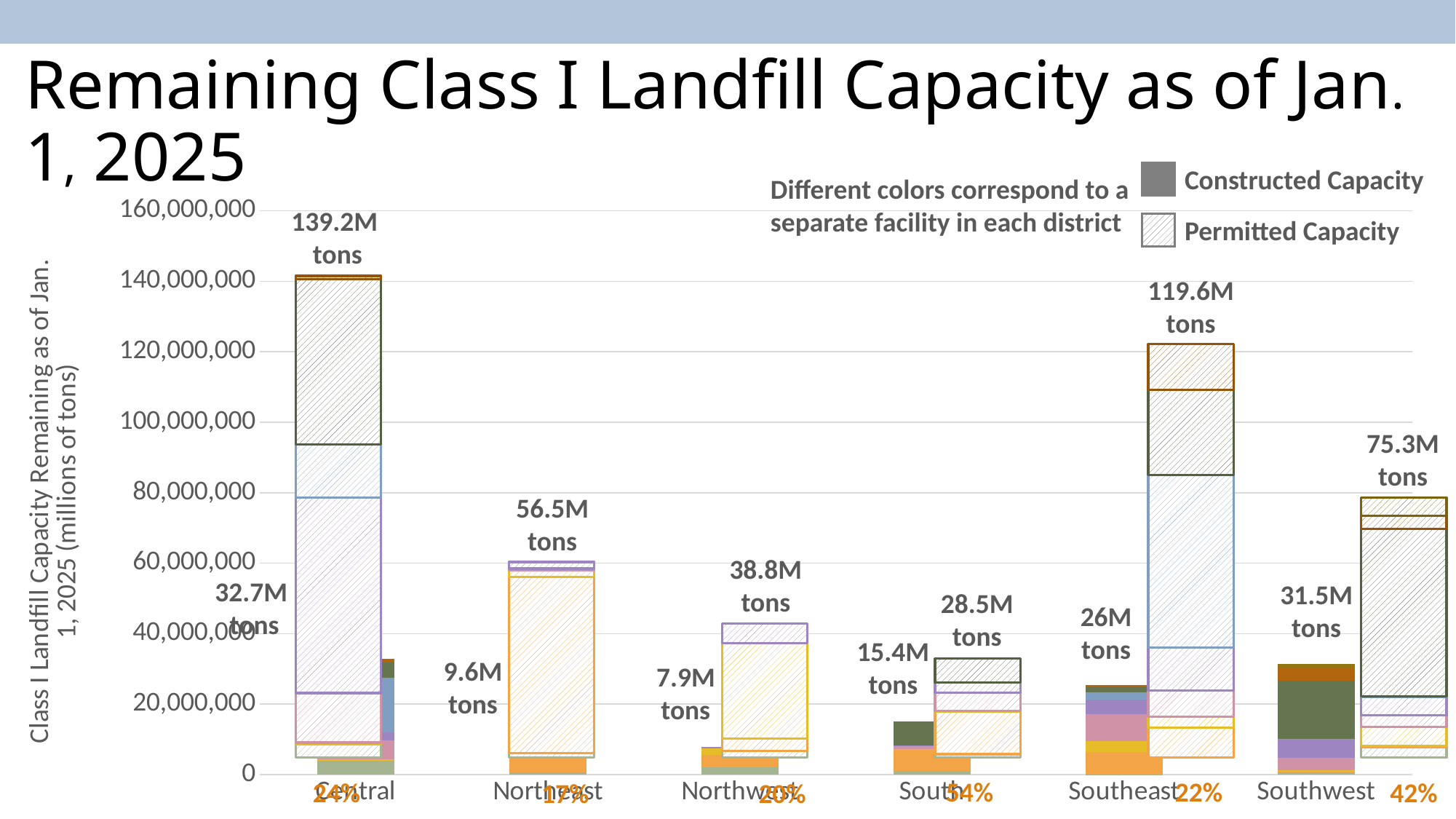
Which is larger, the permitted capacity of Northeast or of Southwest? Southwest Is the permitted capacity for Southeast greater or less than 100,000,000? greater What is the constructed capacity for the Southeast district? 26M tons How many series does the legend list? 2 What is the permitted capacity for the Central district? 139.2M tons What kind of chart is shown on the slide? bar chart Which district has the highest permitted capacity? Central Which district has the lowest permitted capacity? South What is the difference between the permitted capacity of Central and Southeast? 19.6M tons Which district has the lowest constructed capacity? Northwest How many districts are shown on the x axis? 6 What is the permitted capacity for the Northwest district? 38.8M tons